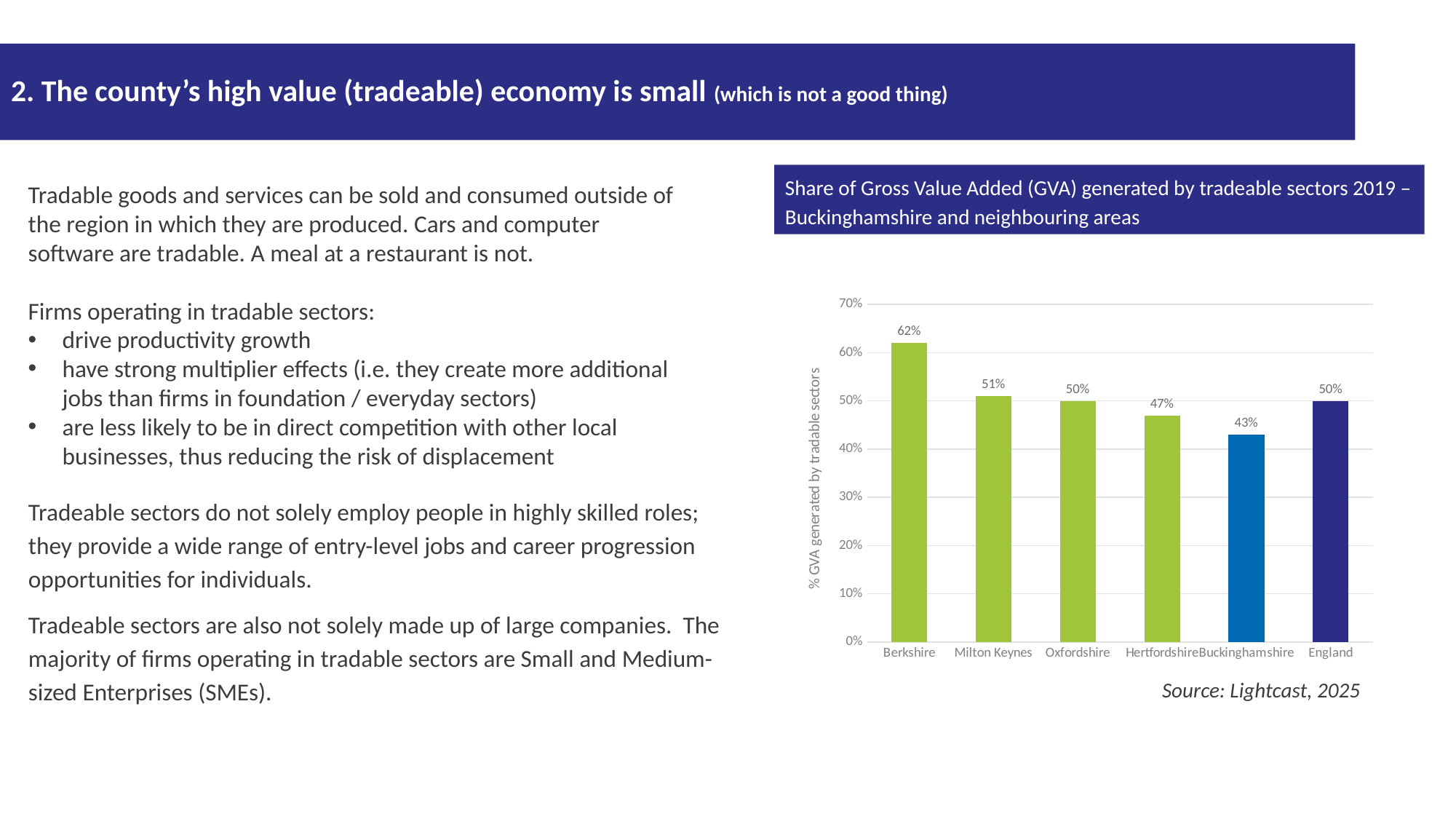
Is the value for Buckinghamshire greater or less than 50%? less What is the share of GVA generated by tradable sectors for Hertfordshire? 47% What is the source cited for the chart? Lightcast, 2025 What kind of chart is shown on the slide? Bar chart Which area has the highest share of GVA generated by tradable sectors? Berkshire What is the share of GVA generated by tradable sectors for England? 50% What is the share of GVA generated by tradable sectors for Buckinghamshire? 43% Which has a larger share of GVA from tradable sectors, Milton Keynes or Hertfordshire? Milton Keynes How many areas are shown on the chart? 6 Which area has the lowest share of GVA generated by tradable sectors? Buckinghamshire What is the share of GVA generated by tradable sectors for Berkshire? 62% What is the difference in percentage points between Berkshire and Buckinghamshire? 19 percentage points